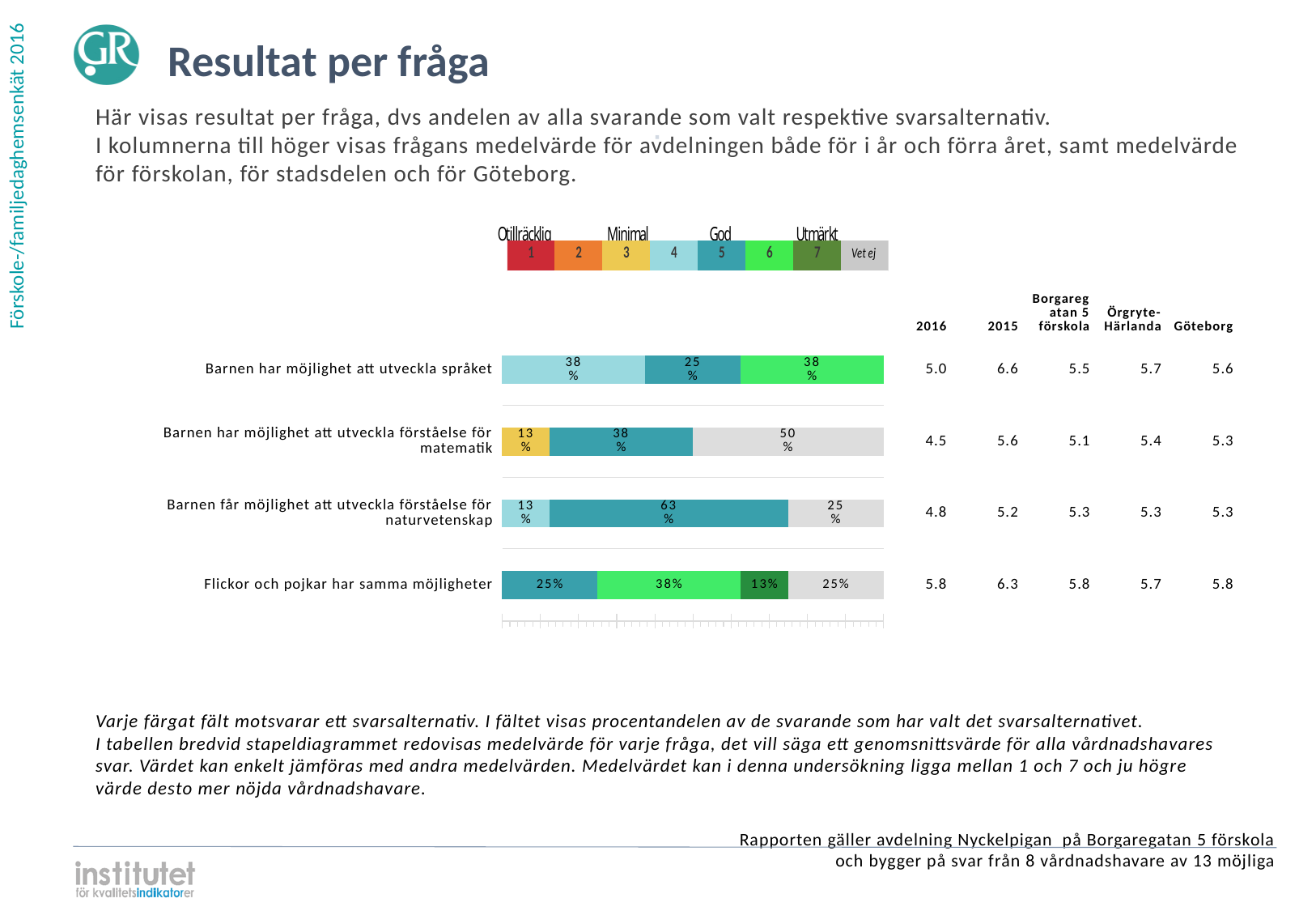
How many questions (bars) are plotted in the chart? 4 What is the largest segment in the bar for 'Barnen får möjlighet att utveckla förståelse för naturvetenskap'? 63% What is the difference between the 63% segment and the 25% segment in the bar for 'Barnen får möjlighet att utveckla förståelse för naturvetenskap'? 38% What is the smallest segment in the bar for 'Barnen har möjlighet att utveckla förståelse för matematik'? 13% What percentage of respondents chose 'Vet ej' for 'Barnen har möjlighet att utveckla förståelse för matematik'? 50% What percentage is shown for the dark green (7) segment in 'Flickor och pojkar har samma möjligheter'? 13% What label does the legend give to the grey colour at the right end of the scale? Vet ej What kind of chart is shown on the slide? Stacked bar chart What percentage is shown for the light blue (4) segment in 'Barnen har möjlighet att utveckla språket'? 38% Which is larger in the bar for 'Flickor och pojkar har samma möjligheter': the bright green (6) segment or the teal (5) segment? The bright green (6) segment How many response options does the colour legend above the chart list? 8 Which bar in the chart has no grey 'Vet ej' segment? Barnen har möjlighet att utveckla språket